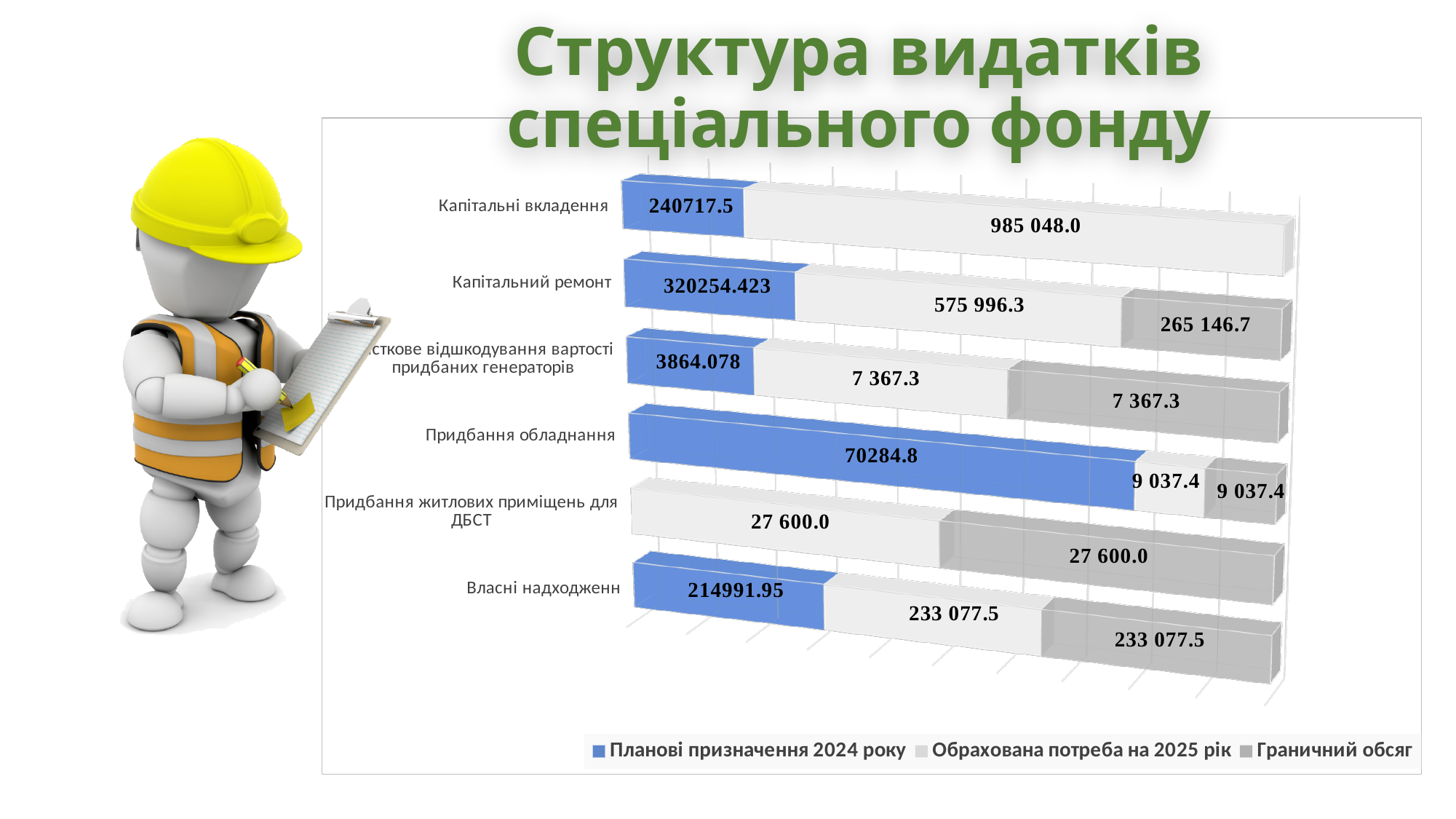
Which category has the highest value for Обрахована потреба на 2025 рік? Капітальні вкладення What is the value of Обрахована потреба на 2025 рік for Капітальні вкладення? 985 048.0 How many series does the legend list? 3 What is the title of the slide? Структура видатків спеціального фонду How many categories are shown on the chart? 6 What is the value of Планові призначення 2024 року for Придбання обладнання? 70284.8 For Капітальний ремонт, what is the difference between Обрахована потреба на 2025 рік and Граничний обсяг? 310 849.6 Which category has the lowest value for Планові призначення 2024 року? Часткове відшкодування вартості придбаних генераторів What is the value of Планові призначення 2024 року for Капітальний ремонт? 320254.423 What kind of chart is shown on the slide? Stacked bar chart For Власні надходженн, which is larger: Планові призначення 2024 року or Обрахована потреба на 2025 рік? Обрахована потреба на 2025 рік What is the value of Граничний обсяг for Власні надходженн? 233 077.5